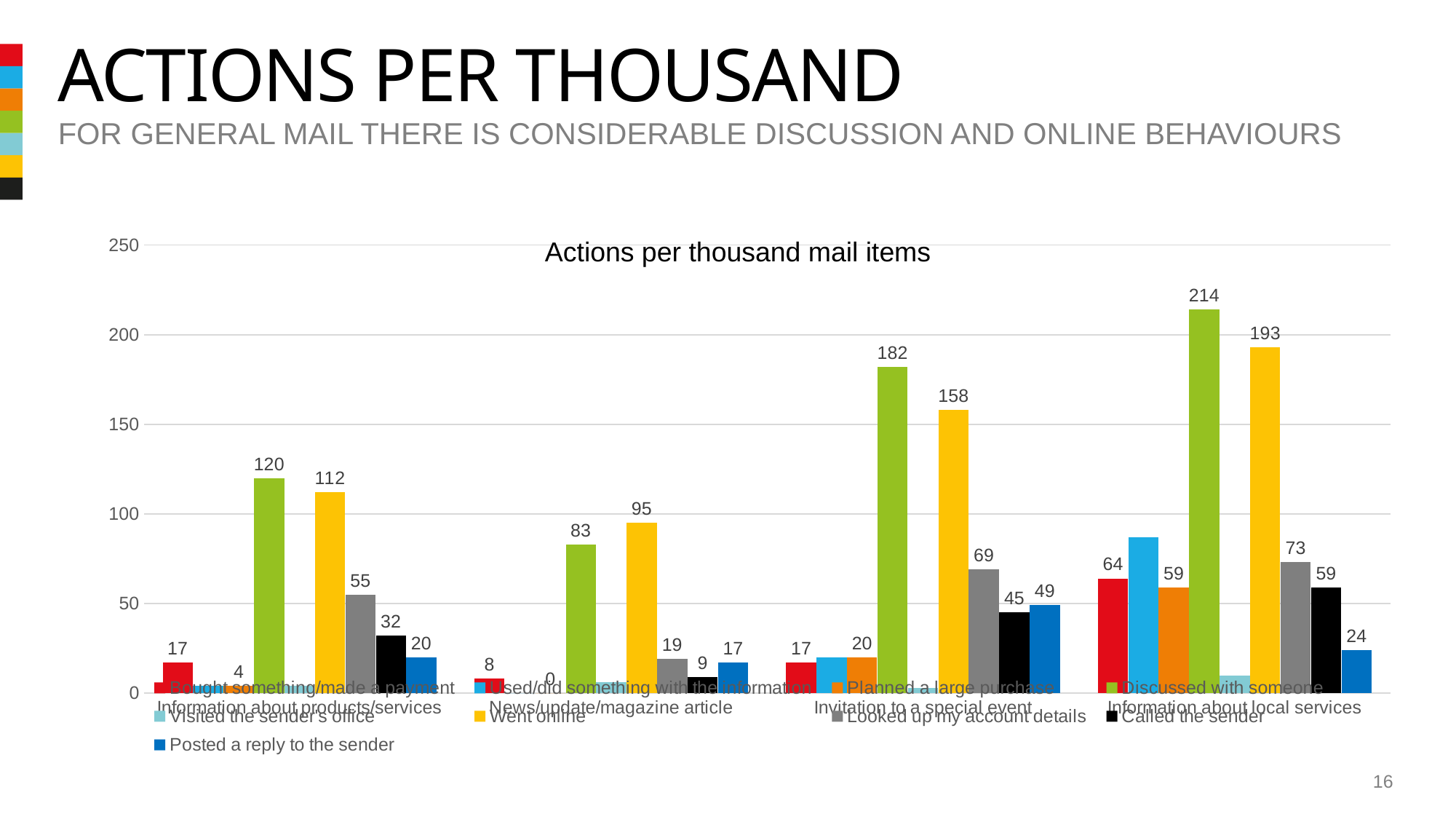
What kind of chart is shown on the slide? bar chart What is the difference between 'Discussed with someone' and 'Went online' for Information about local services? 21 Is the value for 'Used/did something with the information' for Information about local services greater or less than 50? greater What is the value for 'Called the sender' for Invitation to a special event? 45 What is the value for 'Discussed with someone' for Information about local services? 214 For which category is 'Discussed with someone' highest? Information about local services What is the value for 'Went online' for Invitation to a special event? 158 How many series does the legend list? 9 What is the chart's title? Actions per thousand mail items For which category is 'Called the sender' lowest? News/update/magazine article How many mail item categories are shown on the x axis? 4 What is the value for 'Looked up my account details' for Information about products/services? 55